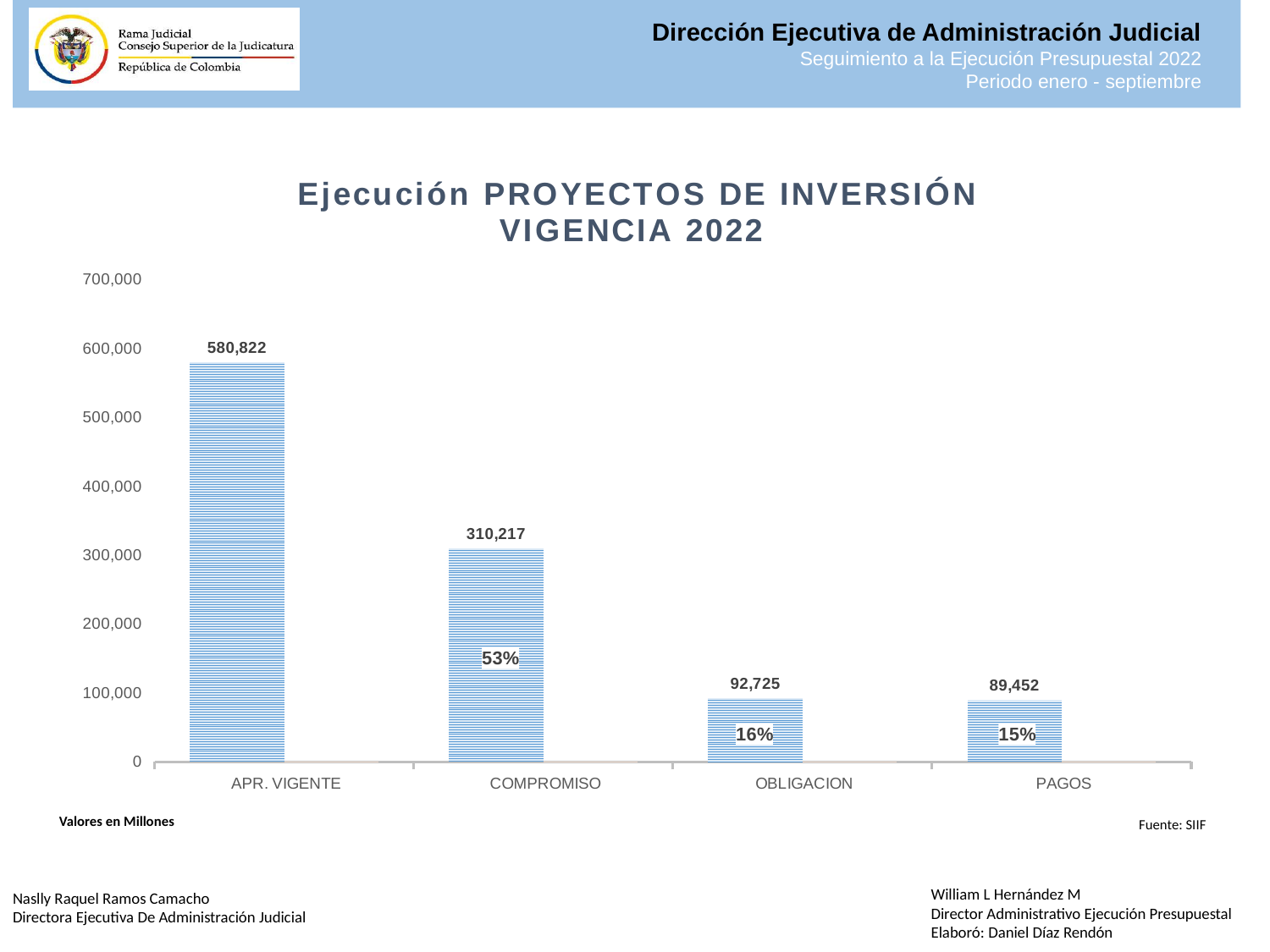
Which is larger, the value for COMPROMISO or the value for OBLIGACION? COMPROMISO Which category has the highest value? APR. VIGENTE What is the value for COMPROMISO? 310,217 How many categories are shown on the x axis? 4 What is the difference between the values for APR. VIGENTE and COMPROMISO? 270,605 What is the value for OBLIGACION? 92,725 What kind of chart is shown on the slide? Bar chart What is the value for APR. VIGENTE? 580,822 What percentage label is shown on the COMPROMISO bar? 53% Which category has the lowest value? PAGOS What is the value for PAGOS? 89,452 What is the difference between the values for OBLIGACION and PAGOS? 3,273